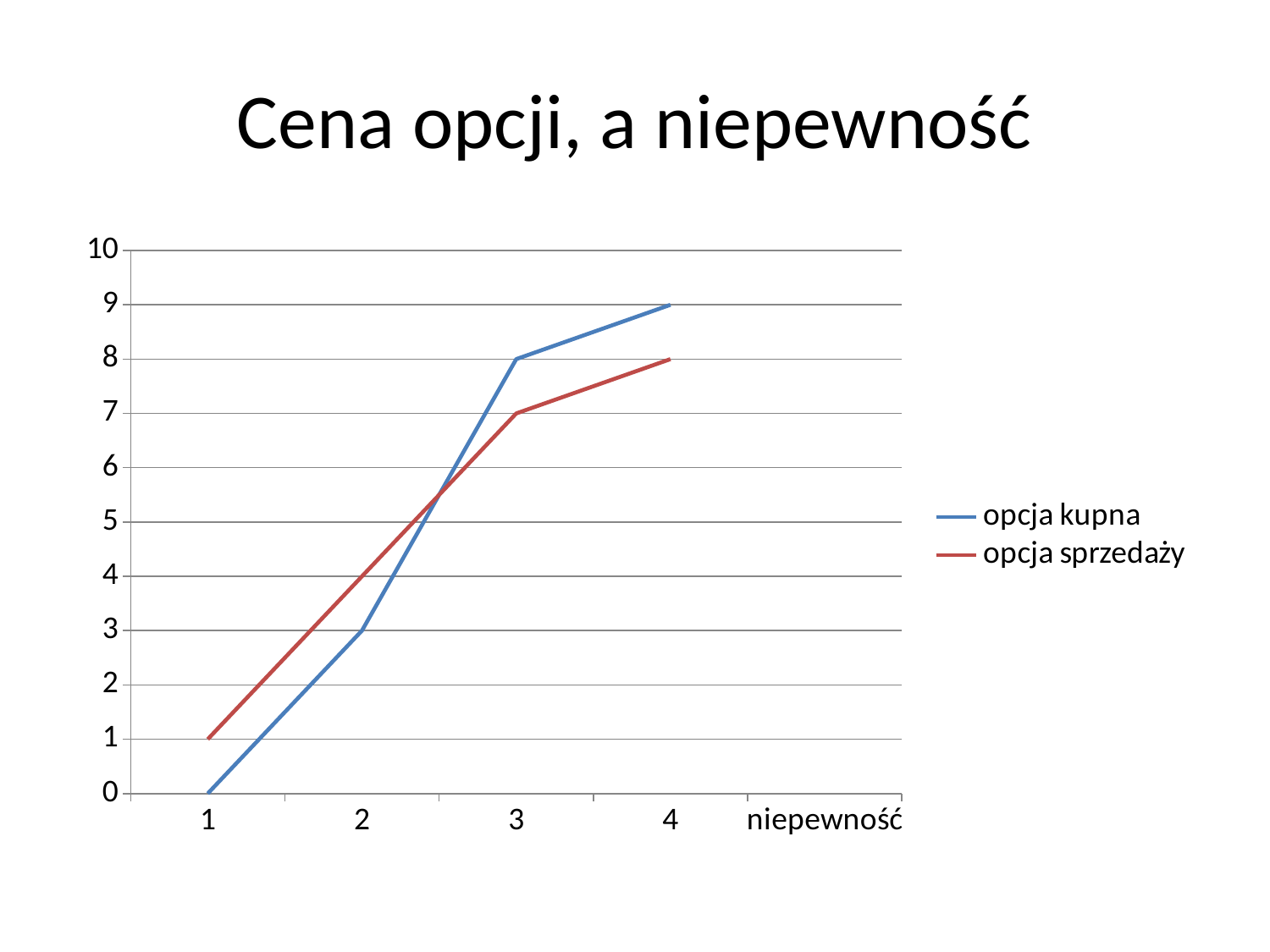
What is the value of opcja sprzedaży at x = 4? 8 What is the title of the chart on the slide? Cena opcji, a niepewność What is the difference between opcja kupna and opcja sprzedaży at x = 4? 1 At x = 2, which series has the larger value, opcja kupna or opcja sprzedaży? opcja sprzedaży What is the value of opcja sprzedaży at x = 1? 1 Do the values of opcja kupna rise or fall as x increases from 1 to 4? rise At which x value is opcja sprzedaży lowest? 1 At which x value does opcja kupna reach its highest value? 4 How many series does the legend list? 2 What is the value of opcja kupna at x = 3? 8 What kind of chart is shown on the slide? line chart What is the value of opcja kupna at x = 1? 0